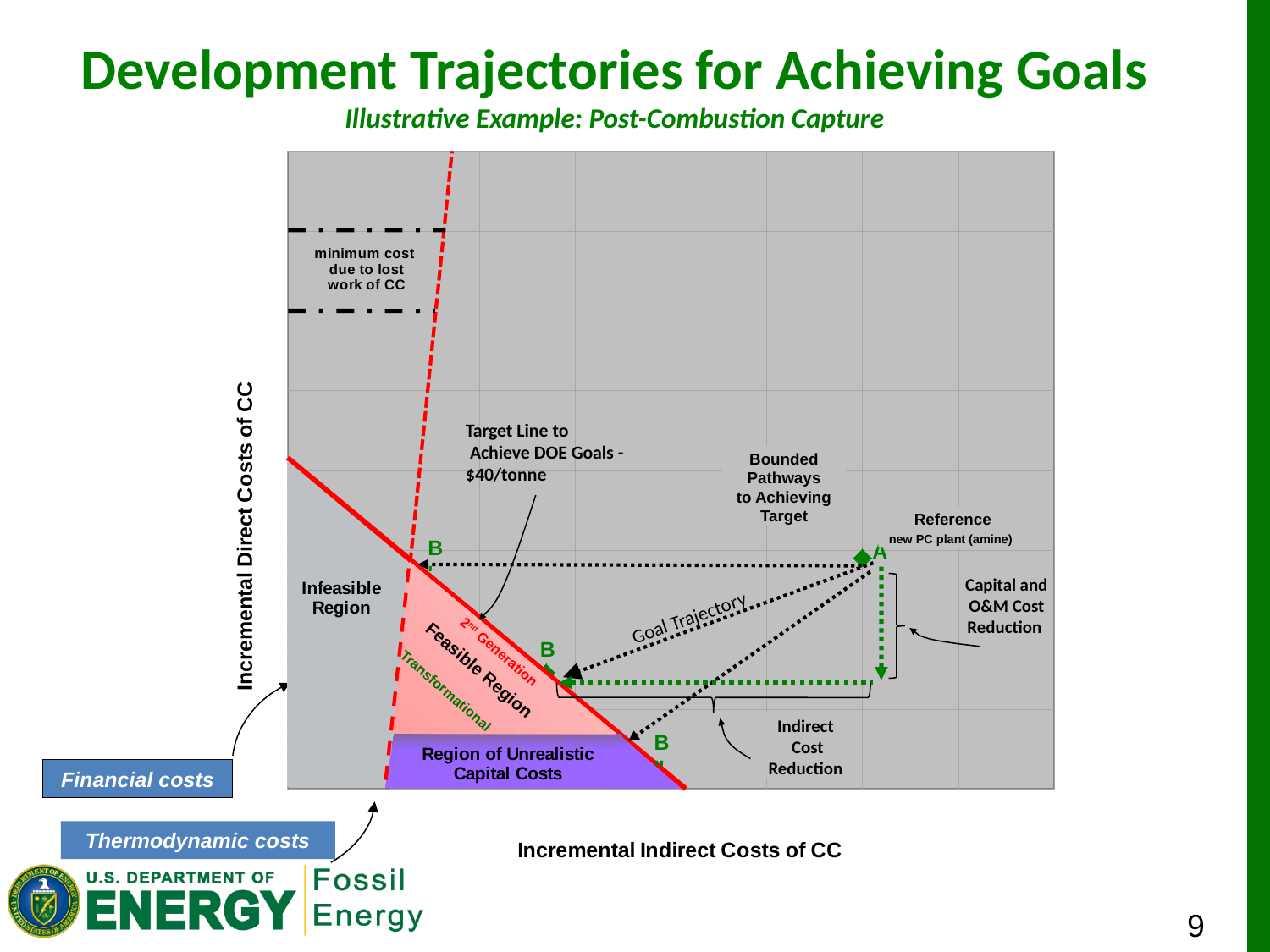
What is the Reference point A described as on the chart? new PC plant (amine) What is the label on the dotted line running from point A to the middle point B? Goal Trajectory What do the dash-dot black lines in the upper left of the chart indicate? minimum cost due to lost work of CC What does the horizontal green dotted arrow represent? Indirect Cost Reduction How many points labeled B are shown on the chart? 3 What is the name of the purple region at the bottom of the chart? Region of Unrealistic Capital Costs What does the vertical green dotted arrow from point A represent? Capital and O&M Cost Reduction What cost per tonne is given for the Target Line to Achieve DOE Goals? $40/tonne What is the label on the horizontal axis of the chart? Incremental Indirect Costs of CC What is the name of the pink shaded region on the chart? Feasible Region What is the label on the vertical axis of the chart? Incremental Direct Costs of CC Which region lies to the left of the red target line? Infeasible Region